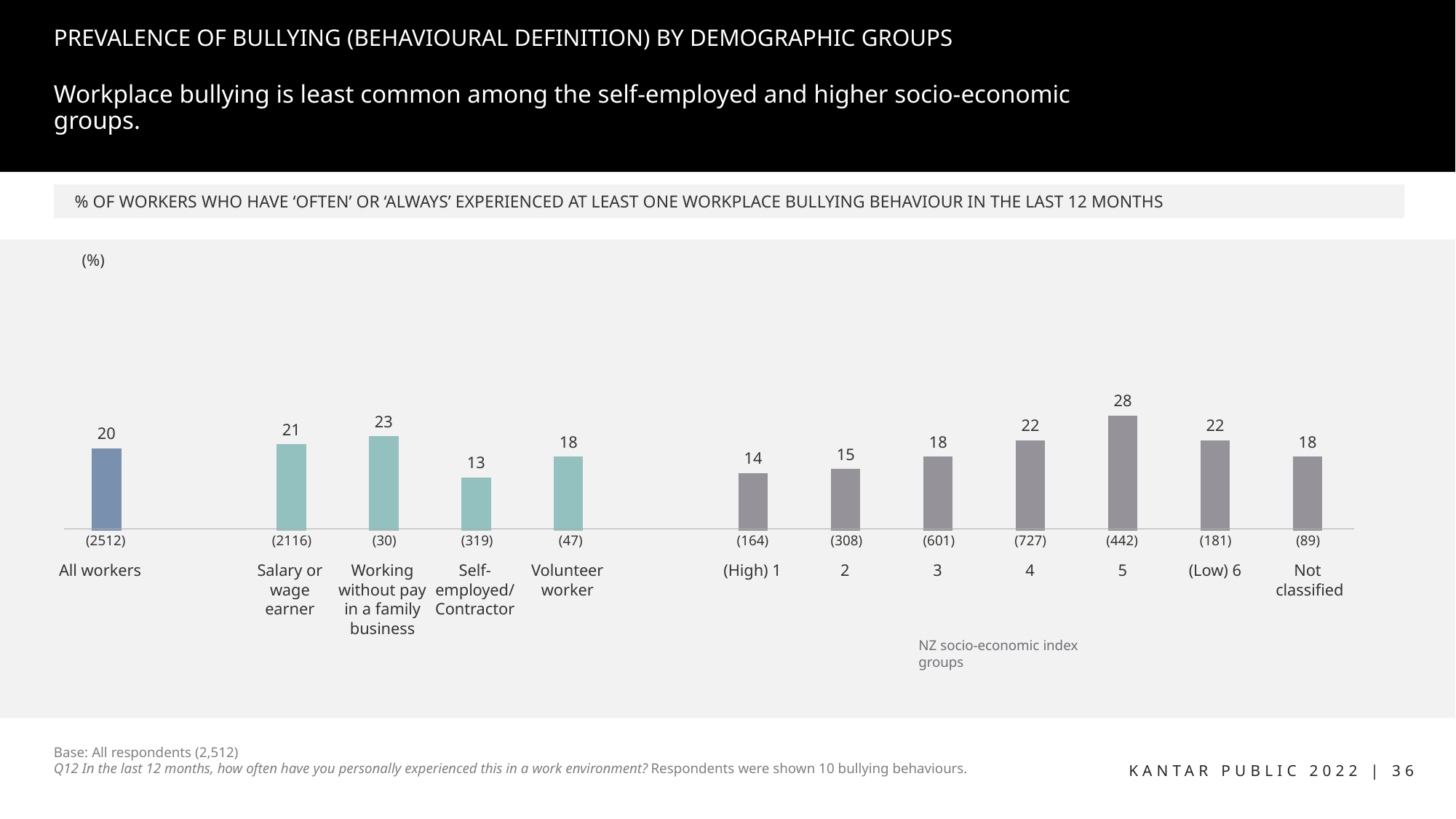
What is the value for All workers? 20 What is the value for socio-economic index group 5? 28 What is the value for Self-employed/Contractor? 13 What is the base size shown under the Volunteer worker bar? (47) What kind of chart is shown on the slide? Bar chart Which is larger, the value for (High) 1 or the value for (Low) 6? (Low) 6 Which category has the highest value? 5 Which category has the lowest value? Self-employed/Contractor What is the difference between the values for Salary or wage earner and Self-employed/Contractor? 8 What is the value for Working without pay in a family business? 23 How many categories are plotted in the chart? 12 Do the values rise or fall from socio-economic index group (High) 1 to group 5? Rise